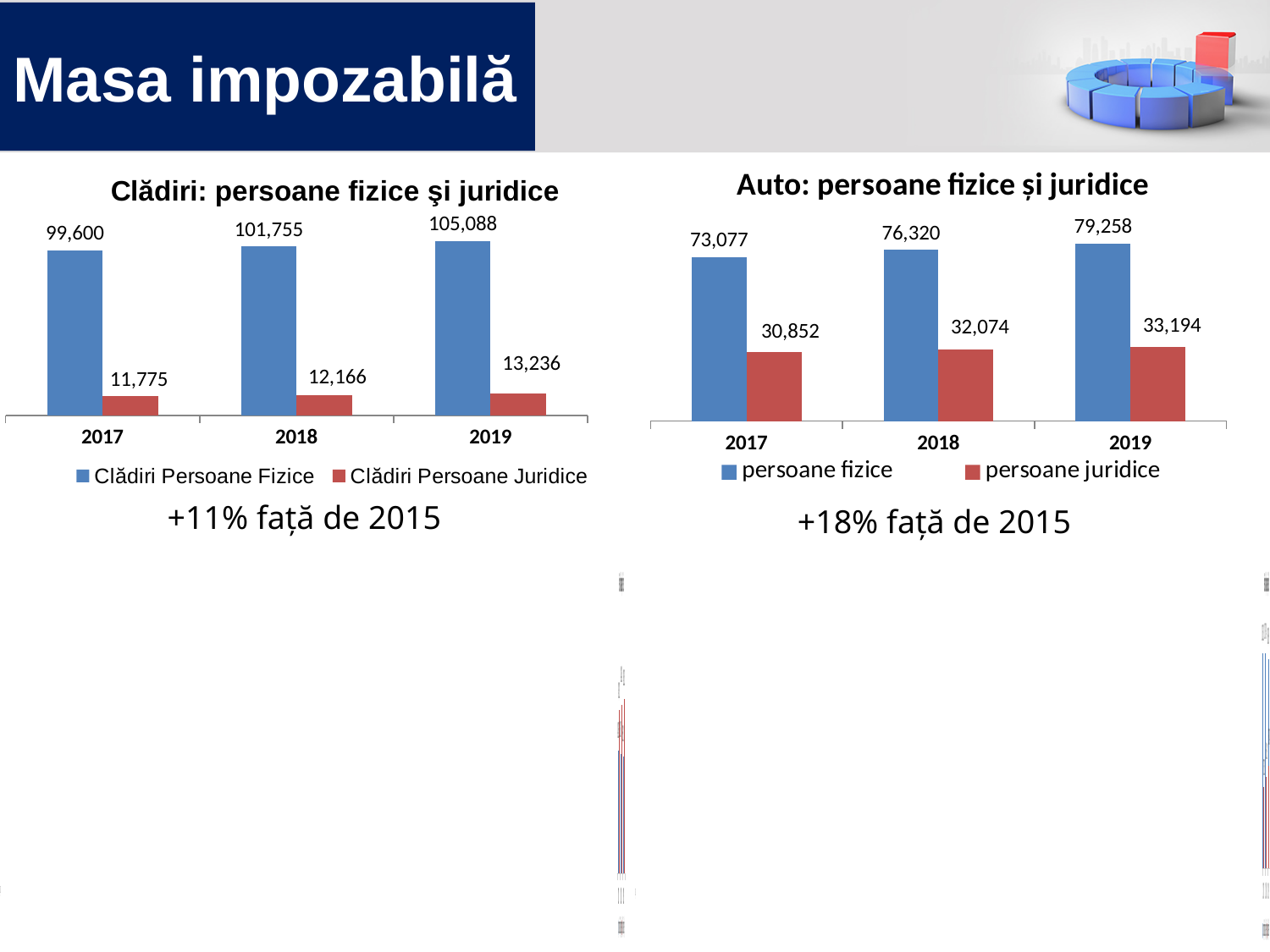
In the chart titled "Clădiri: persoane fizice și juridice", what is the value for Clădiri Persoane Fizice in 2019? 105,088 How many years are shown on the x axis of the chart titled "Clădiri: persoane fizice și juridice"? 3 In the chart titled "Auto: persoane fizice și juridice", what is the difference between the persoane fizice values for 2019 and 2017? 6,181 In the chart titled "Clădiri: persoane fizice și juridice", what is the difference between Clădiri Persoane Fizice and Clădiri Persoane Juridice in 2018? 89,589 In the chart titled "Auto: persoane fizice și juridice", which is larger: persoane fizice in 2018 or persoane juridice in 2019? persoane fizice in 2018 In the chart titled "Clădiri: persoane fizice și juridice", which year has the highest value for Clădiri Persoane Fizice? 2019 How many series does the legend list in the chart titled "Auto: persoane fizice și juridice"? 2 In the chart titled "Auto: persoane fizice și juridice", what is the value for persoane fizice in 2017? 73,077 In the chart titled "Auto: persoane fizice și juridice", what is the value for persoane juridice in 2018? 32,074 In the chart titled "Auto: persoane fizice și juridice", which year has the lowest value for persoane juridice? 2017 In the chart titled "Clădiri: persoane fizice și juridice", what is the value for Clădiri Persoane Juridice in 2017? 11,775 What kind of chart is the chart titled "Clădiri: persoane fizice și juridice"? Bar chart